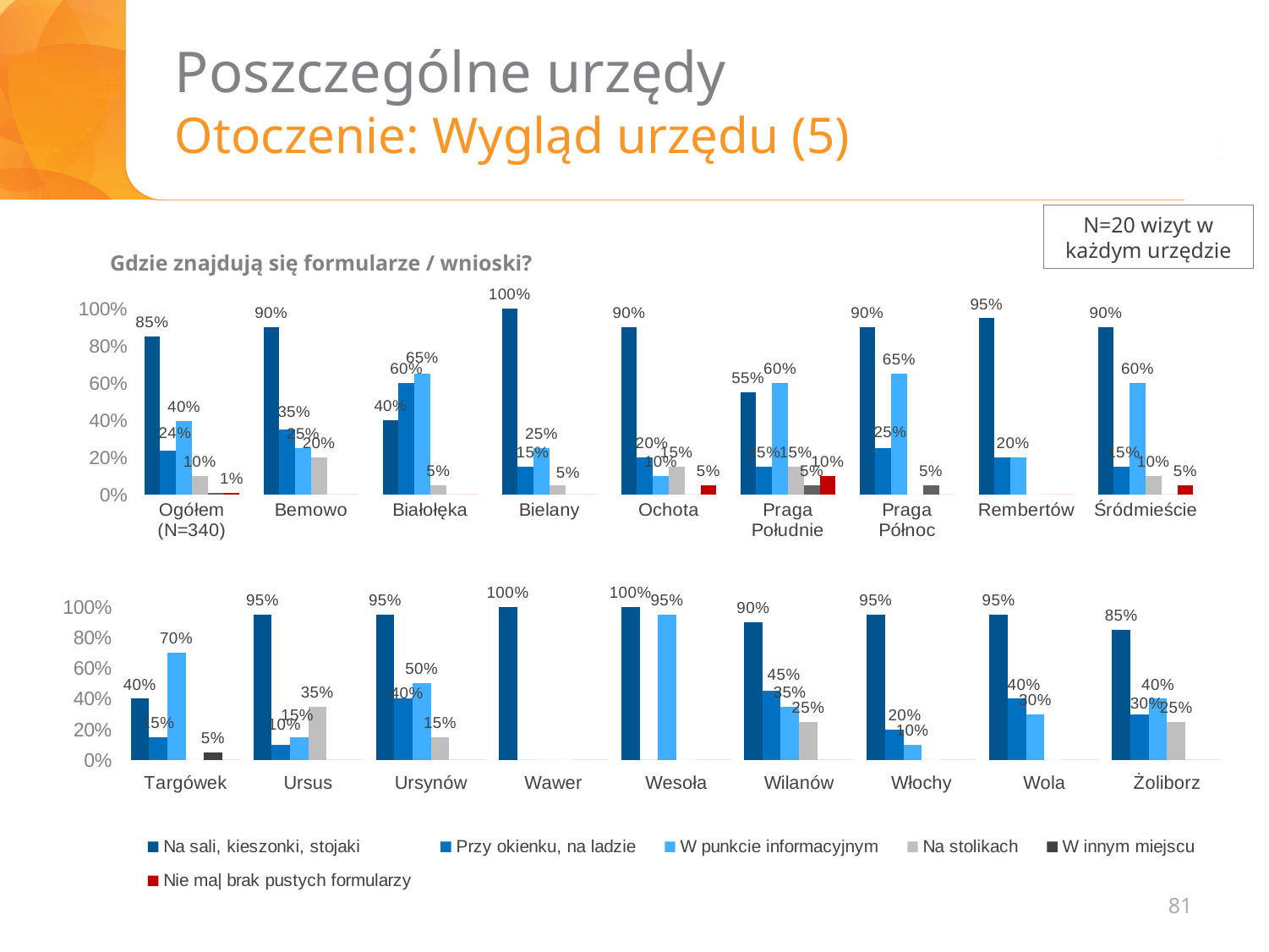
How many series does the legend list? 6 In the bottom chart, which office has the lowest value for 'Na sali, kieszonki, stojaki'? Targówek In the bottom chart, what is the value for 'W punkcie informacyjnym' in Wesoła? 95% What kind of chart is used on this slide? Bar chart How many categories (offices) are shown on the x axis of the top chart? 9 In the top chart, which office has the lowest value for 'Na sali, kieszonki, stojaki'? Białołęka In the top chart, what is the value for 'W punkcie informacyjnym' in Białołęka? 65% In the top chart, for Praga Południe, which is larger: 'Na sali, kieszonki, stojaki' or 'W punkcie informacyjnym'? W punkcie informacyjnym In the top chart, what is the value for 'Przy okienku, na ladzie' for Ogółem (N=340)? 24% In the bottom chart, what is the value for 'W punkcie informacyjnym' in Targówek? 70% In the bottom chart, what is the difference between the 'Na stolikach' values for Ursus and Ursynów? 20 percentage points In the top chart, what is the value for 'Na sali, kieszonki, stojaki' in Bielany? 100%